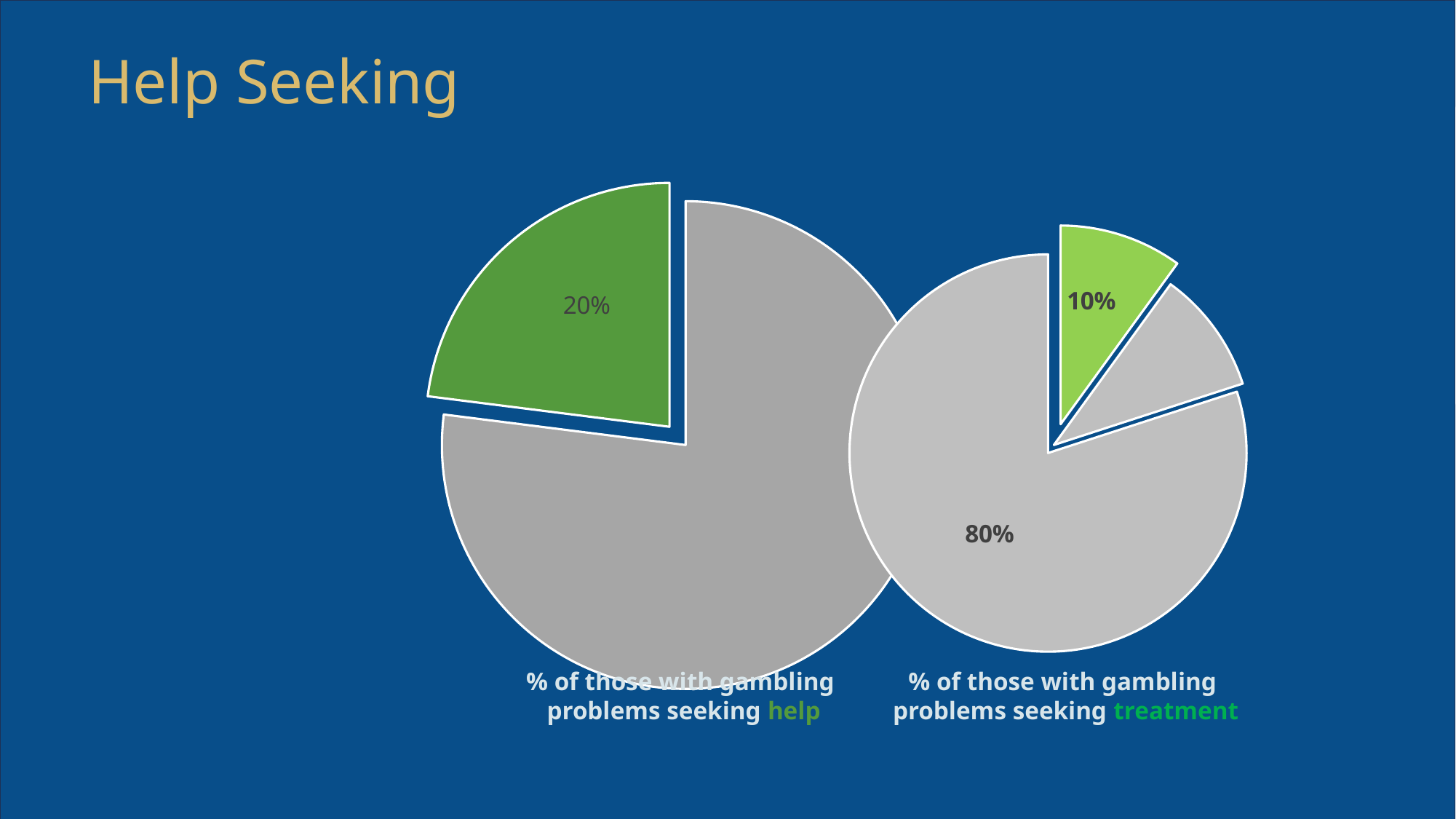
In the right pie chart ('% of those with gambling problems seeking treatment'), which labelled slice is the largest? 80% In the right pie chart ('% of those with gambling problems seeking treatment'), what value is printed on the green slice? 10% What kind of chart is used on the left of the slide, titled '% of those with gambling problems seeking help'? pie chart In the right pie chart ('% of those with gambling problems seeking treatment'), is the green slice larger or smaller than the large grey slice? smaller What kind of chart is used on the right of the slide, titled '% of those with gambling problems seeking treatment'? pie chart How many slices does the right pie chart ('% of those with gambling problems seeking treatment') have? 3 In the right pie chart ('% of those with gambling problems seeking treatment'), what is the difference between the large grey slice and the green slice? 70 percentage points In the left pie chart ('% of those with gambling problems seeking help'), what value is printed on the green slice? 20% In the right pie chart ('% of those with gambling problems seeking treatment'), what value is printed on the large grey slice? 80% How many slices does the left pie chart ('% of those with gambling problems seeking help') have? 2 What is the title of the slide? Help Seeking In the right pie chart ('% of those with gambling problems seeking treatment'), which labelled slice is the smallest? 10%